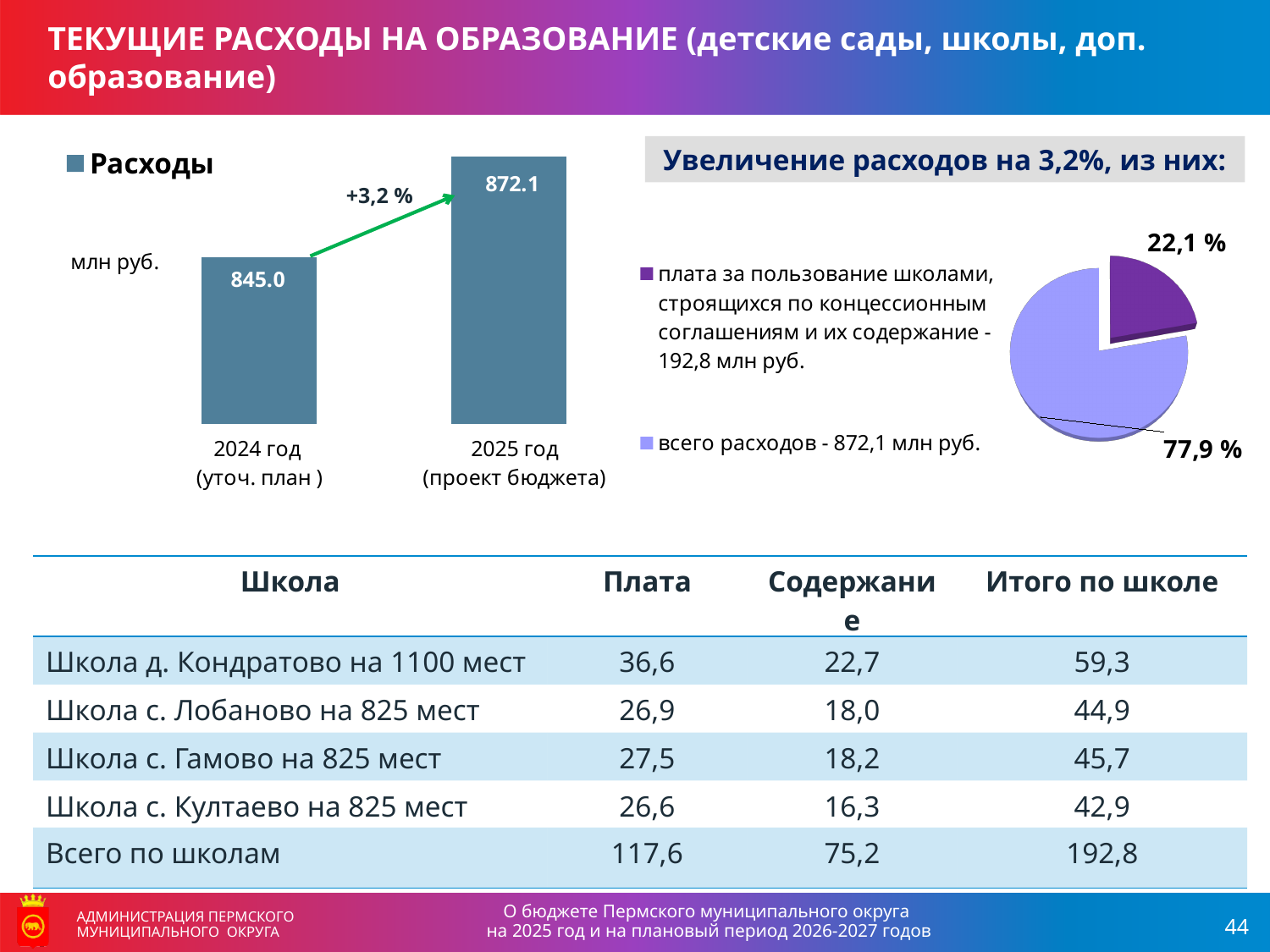
On the pie chart on the right, what share is labelled for the larger slice? 77,9 % On the bar chart on the left, do the values rise or fall from 2024 to 2025? rise What kind of chart is the chart on the right of the slide? pie chart On the bar chart on the left, what is the difference between the 2025 and 2024 values? 27.1 On the pie chart on the right, what share is labelled for the slice 'плата за пользование школами, строящихся по концессионным соглашениям и их содержание'? 22,1 % On the bar chart on the left, what is the value for 2025 год (проект бюджета)? 872.1 On the bar chart on the left, which year has the lower value? 2024 год (уточ. план) What kind of chart is the chart on the left of the slide? bar chart On the bar chart on the left, which year has the higher value? 2025 год (проект бюджета) On the bar chart on the left, what is the value for 2024 год (уточ. план)? 845.0 On the bar chart on the left, what percentage change is written next to the arrow between the bars? +3,2 % How many bars are shown on the bar chart on the left? 2